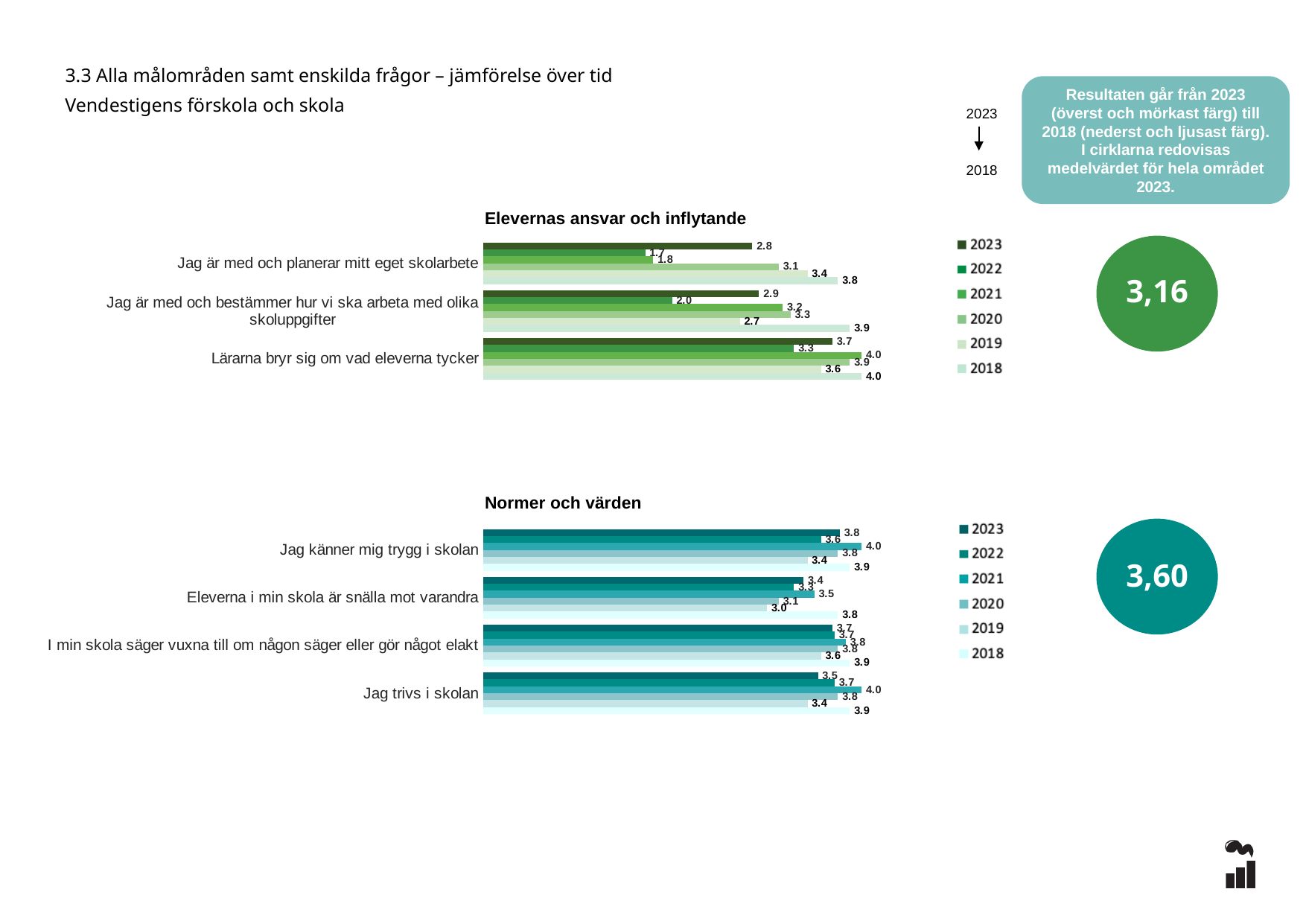
In the 'Elevernas ansvar och inflytande' chart, which category has the highest 2023 value? Lärarna bryr sig om vad eleverna tycker In the 'Elevernas ansvar och inflytande' chart, what is the 2022 value for 'Lärarna bryr sig om vad eleverna tycker'? 3.3 In the 'Normer och värden' chart, which category has the lowest 2023 value? Eleverna i min skola är snälla mot varandra What type of chart is 'Normer och värden'? Bar chart In the 'Normer och värden' chart, is the 2023 value for 'Jag känner mig trygg i skolan' larger or smaller than the 2023 value for 'Jag trivs i skolan'? larger How many categories are shown in the 'Normer och värden' chart? 4 In the 'Elevernas ansvar och inflytande' chart, what is the 2023 value for 'Jag är med och planerar mitt eget skolarbete'? 2.8 In the 'Normer och värden' chart, what is the 2021 value for 'Jag känner mig trygg i skolan'? 4.0 How many series does the legend of the 'Elevernas ansvar och inflytande' chart list? 6 In the 'Elevernas ansvar och inflytande' chart, what is the difference between the 2018 and 2023 values for 'Jag är med och planerar mitt eget skolarbete'? 1.0 In the 'Elevernas ansvar och inflytande' chart, what is the 2018 value for 'Jag är med och bestämmer hur vi ska arbeta med olika skoluppgifter'? 3.9 In the 'Normer och värden' chart, what is the 2019 value for 'Eleverna i min skola är snälla mot varandra'? 3.0